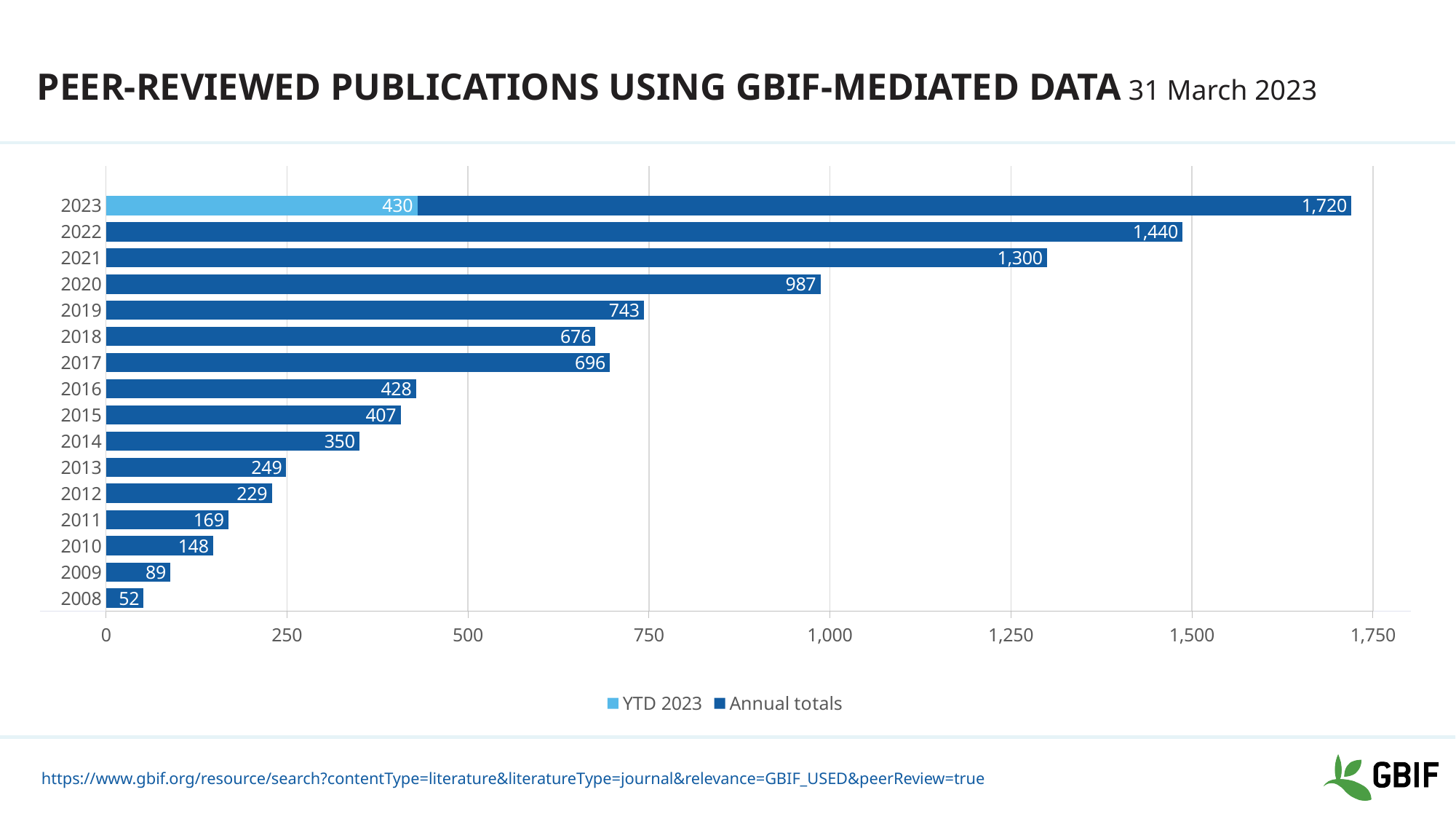
How many series does the legend list? 2 How many years are shown on the chart? 16 What type of chart is shown on the slide? bar chart What is the annual total of peer-reviewed publications for 2022? 1,440 What is the value shown for 2008? 52 Which year has the lowest value on the chart? 2008 What is the difference between the values for 2022 and 2021? 140 What is the value shown for 2020? 987 What are the two series named in the legend? YTD 2023 and Annual totals Is the value for 2019 greater or less than 750? less Which year has the larger value, 2017 or 2018? 2017 What is the YTD 2023 value shown on the chart? 430